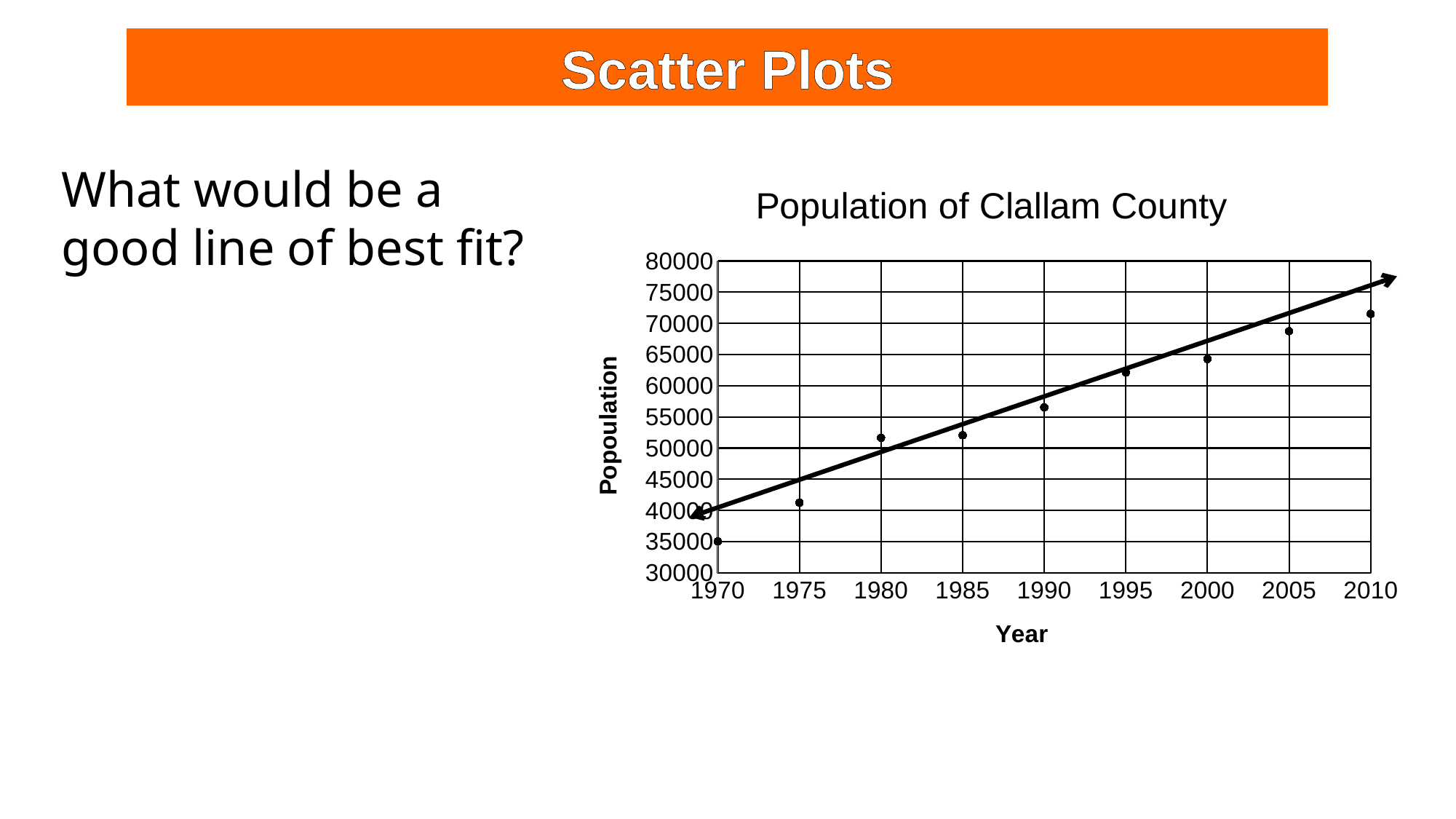
What is the label on the x axis of the chart? Year What type of chart is shown on the slide? Scatter plot Is the population value for 2005 greater or less than 70000? less Which year has the larger population, 1985 or 1995? 1995 Which year has the highest population on the chart? 2010 Which year has the lowest population on the chart? 1970 Is the population value for 1975 greater or less than 45000? less Do the population values rise or fall as the years increase along the x axis? Rise How many data points are plotted on the chart? 9 What is the title of the chart? Population of Clallam County Is the population value for 2010 greater or less than 70000? greater